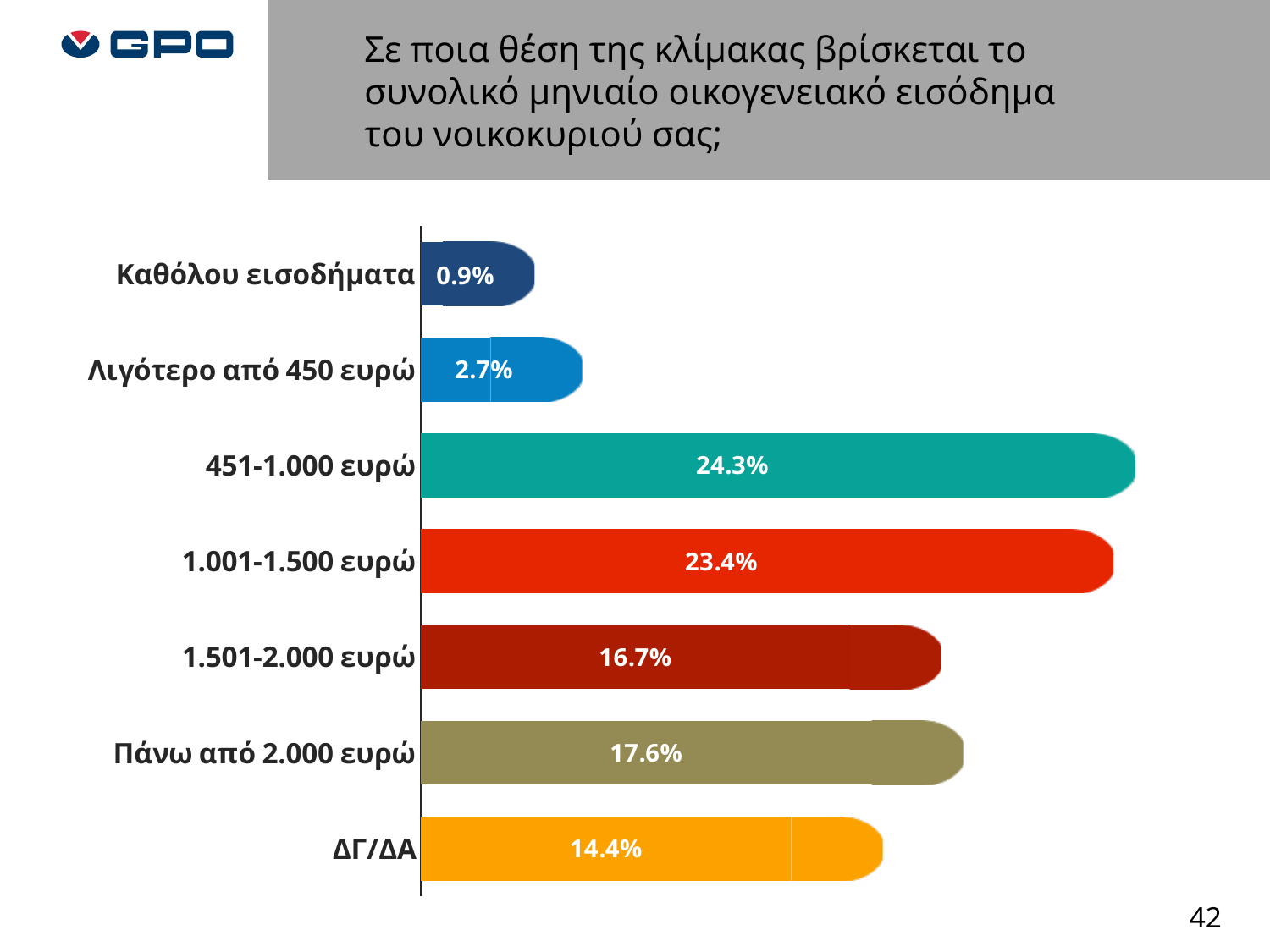
Which is larger: the value for 'Λιγότερο από 450 ευρώ' or the value for 'Καθόλου εισοδήματα'? Λιγότερο από 450 ευρώ Which is larger: the value for '1.501-2.000 ευρώ' or the value for 'ΔΓ/ΔΑ'? 1.501-2.000 ευρώ What is the difference between the values for 'Πάνω από 2.000 ευρώ' and '1.501-2.000 ευρώ'? 0.9% What percentage of respondents reported a monthly household income of 451-1.000 ευρώ? 24.3% What is the value shown for the category 'Καθόλου εισοδήματα'? 0.9% Which category has the lowest percentage? Καθόλου εισοδήματα What percentage is shown for 'ΔΓ/ΔΑ'? 14.4% How many income categories are shown in the chart? 7 What type of chart is shown on the slide? Bar chart What is the difference between the values for '451-1.000 ευρώ' and '1.001-1.500 ευρώ'? 0.9% Which income category has the highest percentage? 451-1.000 ευρώ What is the value for 'Πάνω από 2.000 ευρώ'? 17.6%